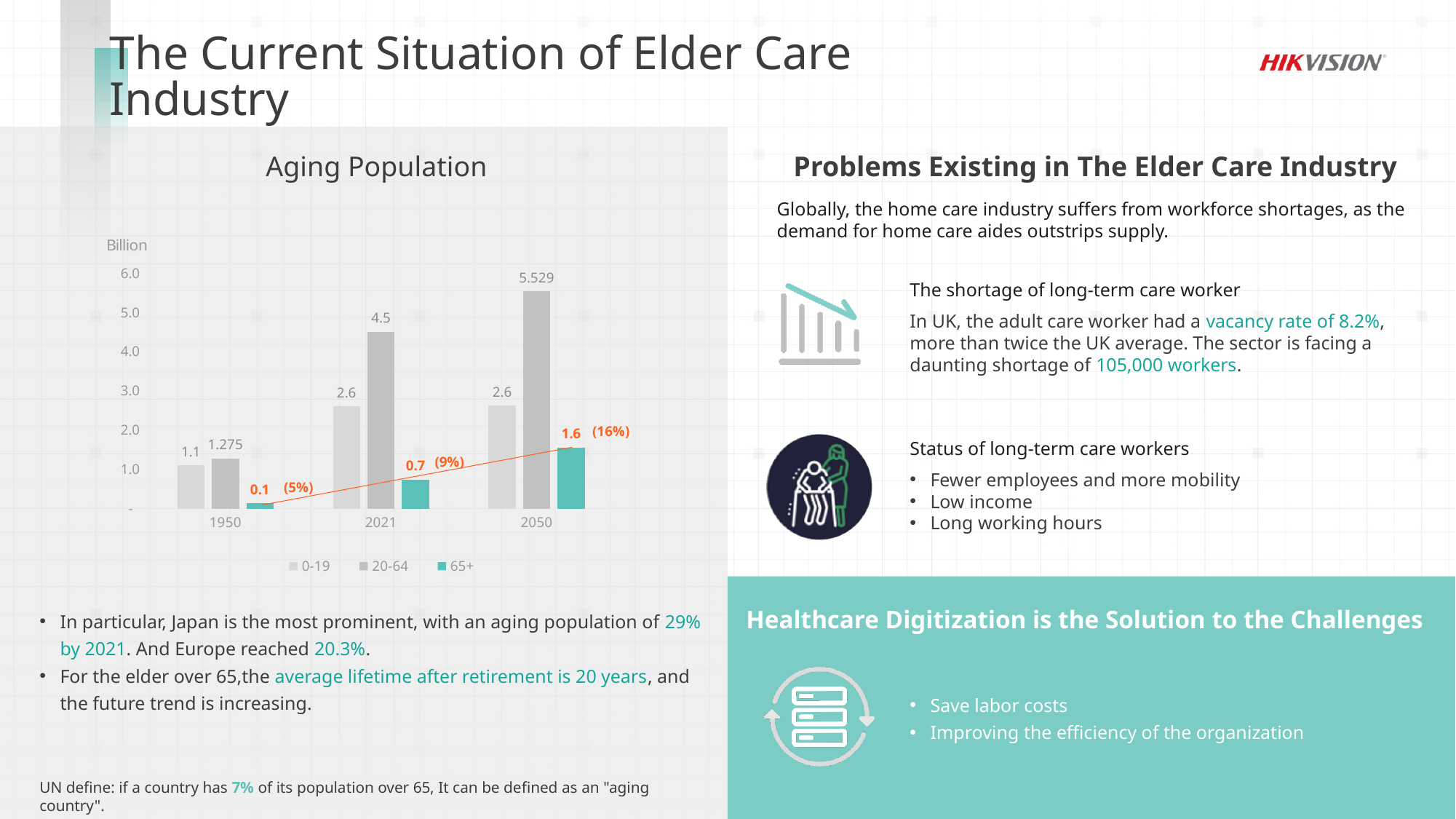
In the Aging Population chart, which year has the highest value for the 65+ series? 2050 In the Aging Population chart, do the values for the 65+ series rise or fall from 1950 to 2050? rise What type of chart is the Aging Population chart? bar chart In the Aging Population chart, what is the value for the 65+ series in 2021? 0.7 In the Aging Population chart, what is the value for the 20-64 series in 1950? 1.275 How many years are shown on the x axis of the Aging Population chart? 3 In the Aging Population chart, which year has the lowest value for the 20-64 series? 1950 In the Aging Population chart, what is the value for the 0-19 series in 1950? 1.1 In the Aging Population chart, which is larger in 2021: the 0-19 value or the 20-64 value? 20-64 In the Aging Population chart, what is the difference between the 20-64 values for 2050 and 2021? 1.029 In the Aging Population chart, what is the value for the 20-64 series in 2050? 5.529 How many series does the legend of the Aging Population chart list? 3